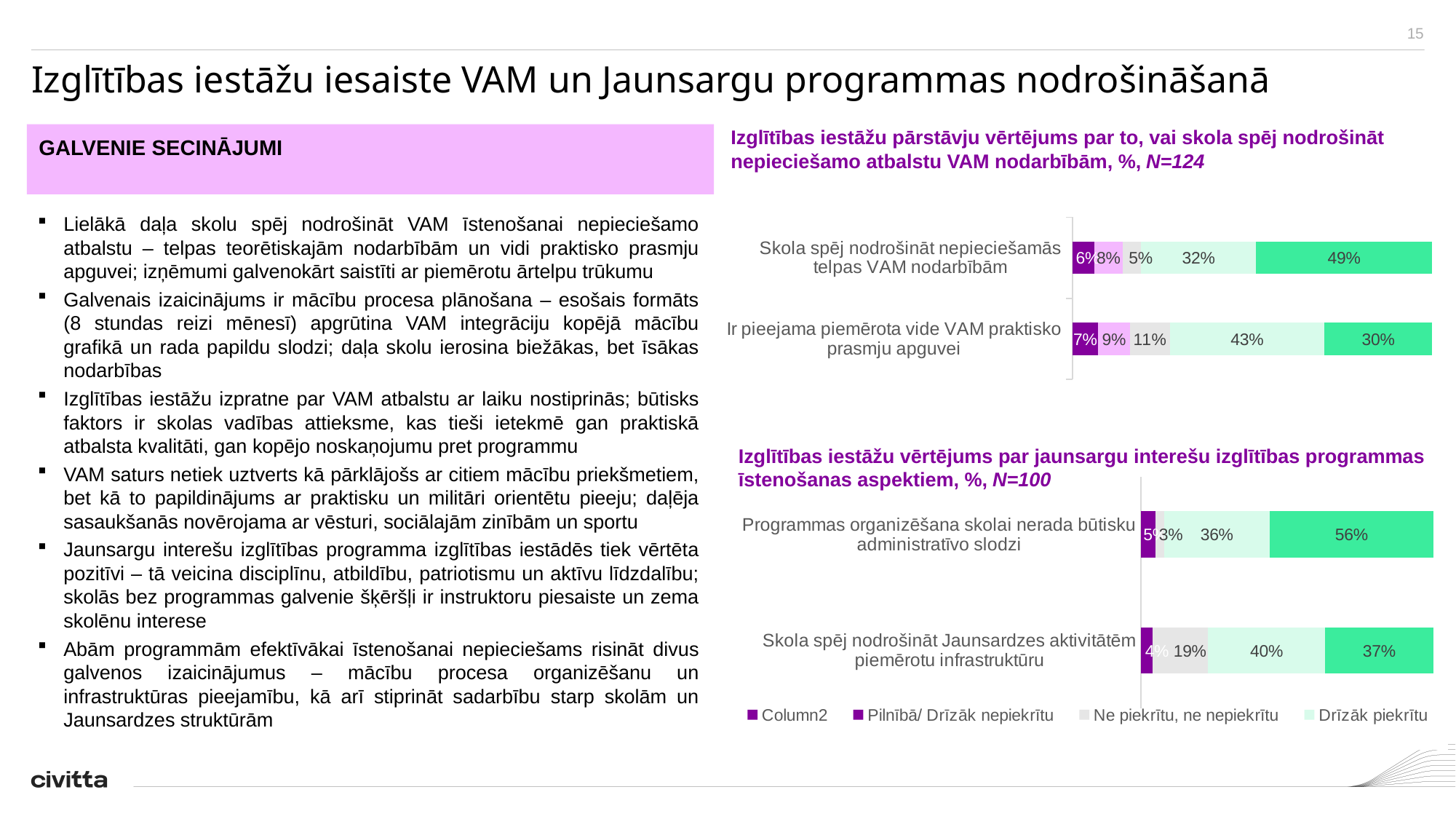
What type of chart is the top chart (VAM nodarbībām, N=124)? Stacked bar chart In the top chart (VAM nodarbībām, N=124), what is the "Ne piekrītu, ne nepiekrītu" value for "Ir pieejama piemērota vide VAM praktisko prasmju apguvei"? 11% In the bottom chart (jaunsargu programmas, N=100), what is the difference between the largest segment of "Programmas organizēšana skolai nerada būtisku administratīvo slodzi" (56%) and the largest segment of "Skola spēj nodrošināt Jaunsardzes aktivitātēm piemērotu infrastruktūru" (37%)? 19 percentage points In the bottom chart (jaunsargu programmas, N=100), what is the value of the largest segment for "Programmas organizēšana skolai nerada būtisku administratīvo slodzi"? 56% In the top chart (VAM nodarbībām, N=124), what is the "Drīzāk piekrītu" value for "Ir pieejama piemērota vide VAM praktisko prasmju apguvei"? 43% In the bottom chart (jaunsargu programmas, N=100), what is the "Ne piekrītu, ne nepiekrītu" value for "Skola spēj nodrošināt Jaunsardzes aktivitātēm piemērotu infrastruktūru"? 19% In the top chart (VAM nodarbībām, N=124), what is the total of all segments in the bar for "Skola spēj nodrošināt nepieciešamās telpas VAM nodarbībām"? 100% In the top chart (VAM nodarbībām, N=124), how many statements (bars) are shown? 2 In the top chart (VAM nodarbībām, N=124), which statement has the larger "Drīzāk piekrītu" share? Ir pieejama piemērota vide VAM praktisko prasmju apguvei What sample size (N) is stated in the title of the bottom chart about the jaunsargu programme? N=100 In the top chart (VAM nodarbībām, N=124), what is the value of the largest segment for "Skola spēj nodrošināt nepieciešamās telpas VAM nodarbībām"? 49% In the top chart (VAM nodarbībām, N=124), what is the difference between the largest segment of "Skola spēj nodrošināt nepieciešamās telpas VAM nodarbībām" (49%) and the largest segment of "Ir pieejama piemērota vide VAM praktisko prasmju apguvei" (30%)? 19 percentage points